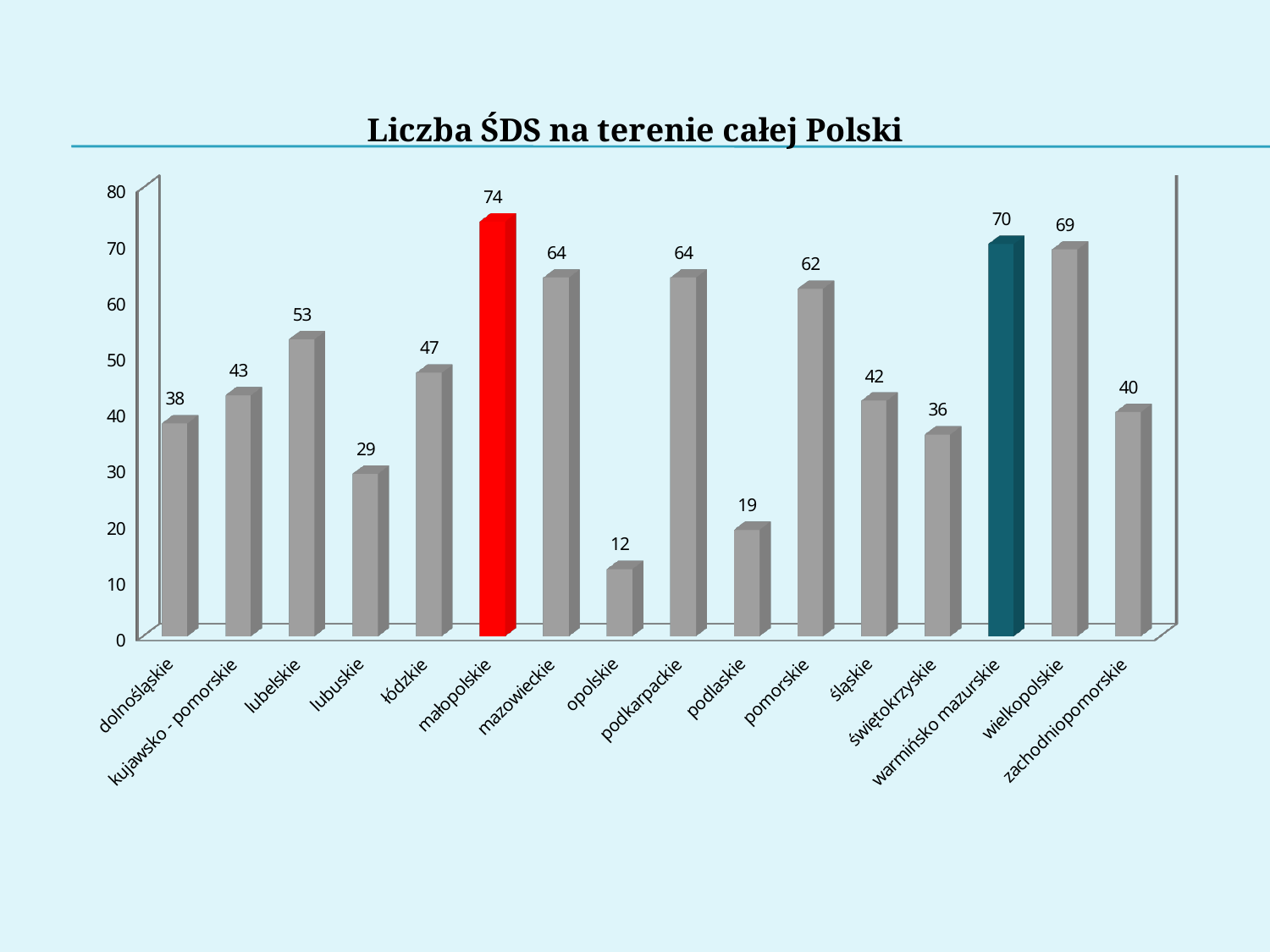
Which voivodeship has the highest number of ŚDS? małopolskie Which voivodeship has the lowest number of ŚDS? opolskie What is the value for warmińsko mazurskie? 70 Which is larger, the value for lubelskie or the value for łódzkie? lubelskie What is the title of the chart? Liczba ŚDS na terenie całej Polski Which bar is coloured red? małopolskie What is the value for małopolskie? 74 How many categories are shown on the x axis? 16 What is the difference between the values for małopolskie and opolskie? 62 What is the value for opolskie? 12 What is the difference between the values for wielkopolskie and zachodniopomorskie? 29 What kind of chart is shown on the slide? bar chart